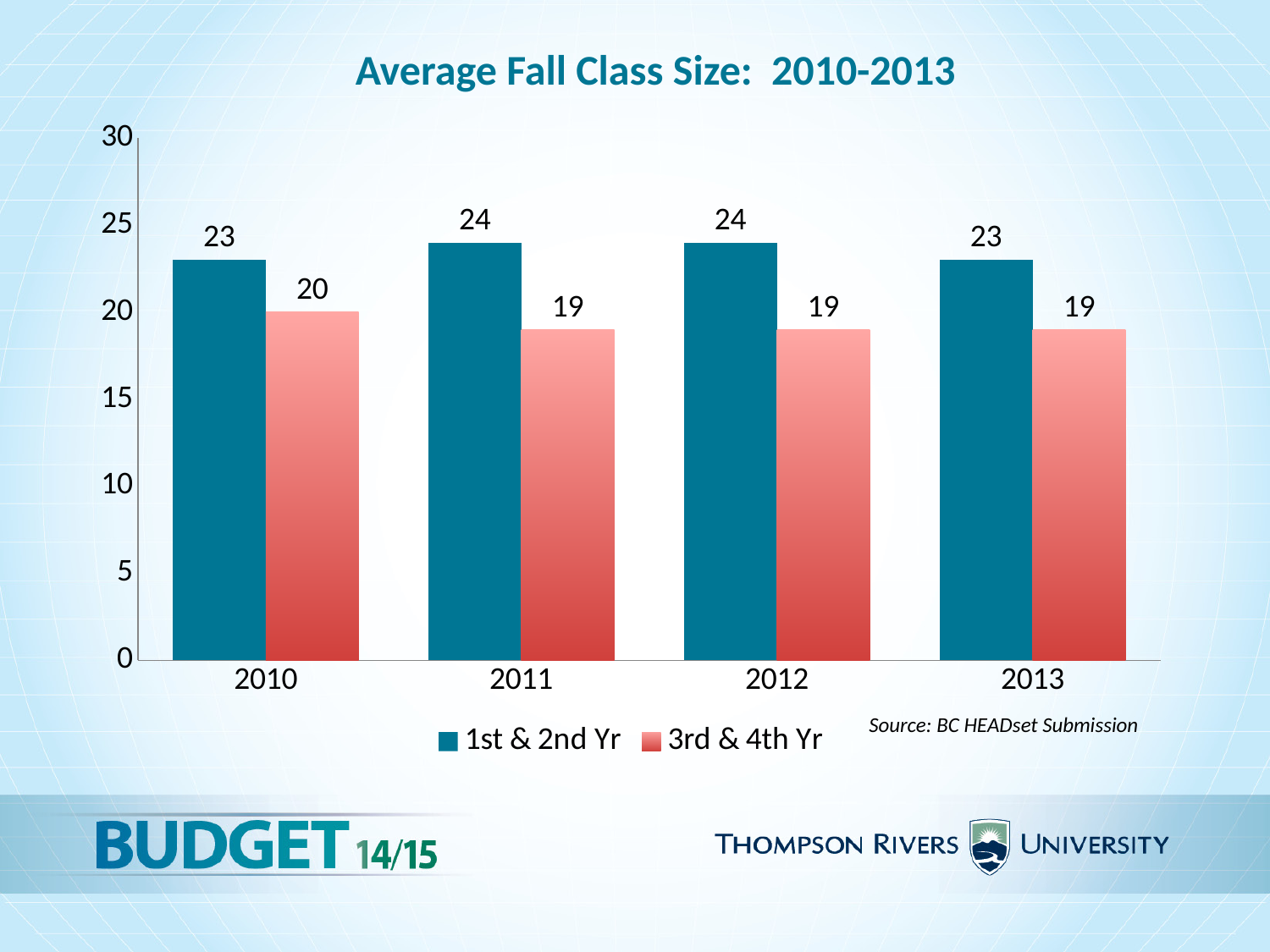
What is the difference between the 1st & 2nd Yr and 3rd & 4th Yr values in 2012? 5 In which year is the 3rd & 4th Yr class size highest? 2010 How many years are shown on the x axis? 4 What is the title of the chart? Average Fall Class Size: 2010-2013 What is the source cited for the chart data? BC HEADset Submission What kind of chart is shown on the slide? bar chart Is the 3rd & 4th Yr value for 2011 greater or less than 20? less What is the value for 1st & 2nd Yr in 2013? 23 Which is larger in 2010: the 1st & 2nd Yr value or the 3rd & 4th Yr value? 1st & 2nd Yr How many series does the legend list? 2 What is the average fall class size for 1st & 2nd Yr in 2011? 24 What is the average fall class size for 3rd & 4th Yr in 2010? 20